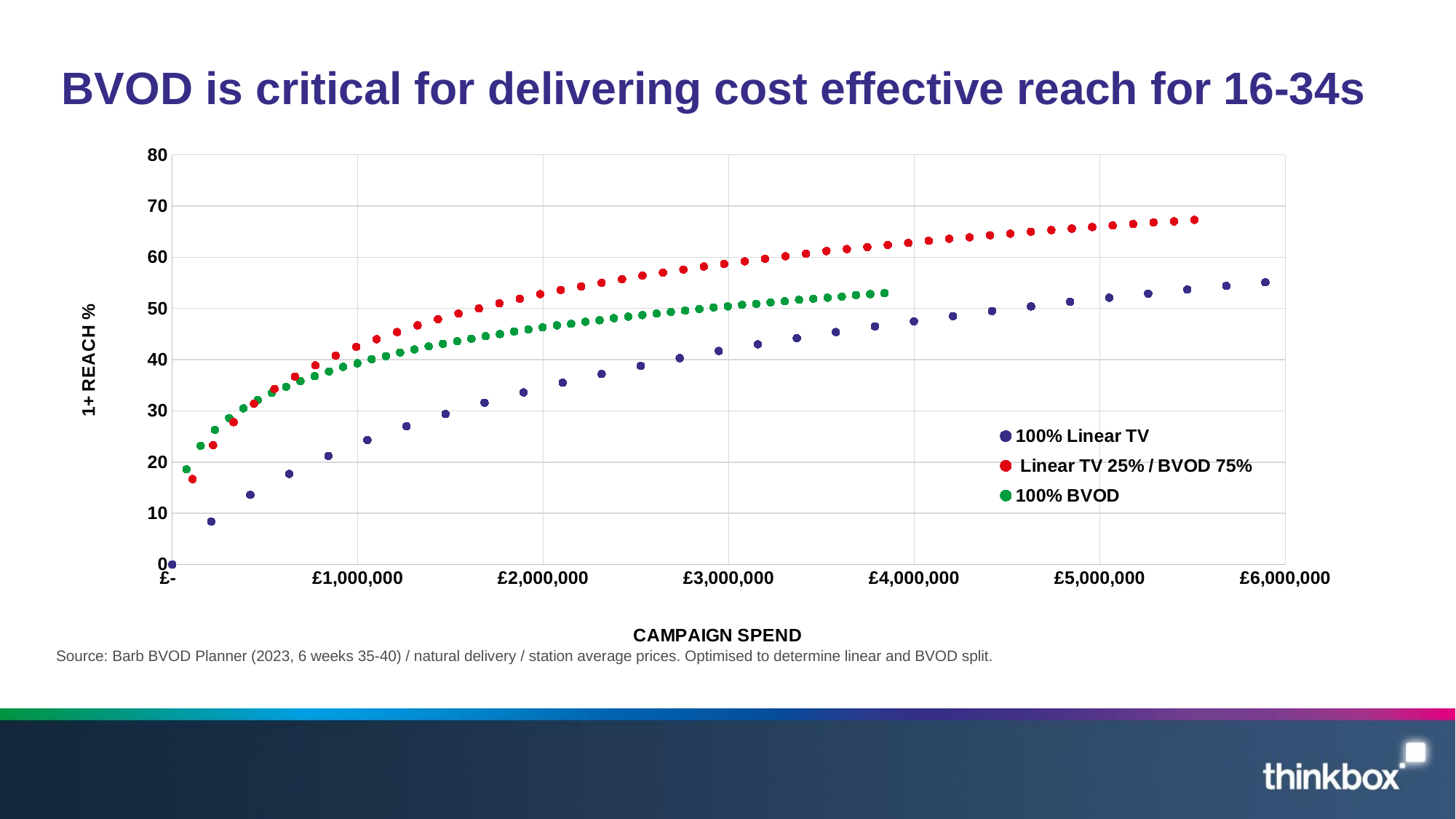
As campaign spend increases along the x axis, does 1+ reach % rise or fall for each series? Rise What are the three series listed in the chart legend? 100% Linear TV, Linear TV 25% / BVOD 75%, 100% BVOD At a campaign spend of £1,000,000, is the 1+ reach % for 100% Linear TV greater or less than 30? less Which series reaches the highest 1+ reach % anywhere on the chart? Linear TV 25% / BVOD 75% What kind of chart is shown on the slide? Scatter chart At a campaign spend of £1,000,000, is the 1+ reach % for 100% BVOD greater or less than 30? greater Is the highest 1+ reach % achieved by the 100% BVOD series greater or less than 60? less At a campaign spend of £2,000,000, which series has the higher 1+ reach %: 100% Linear TV or 100% BVOD? 100% BVOD What is the label on the vertical axis of the chart? 1+ REACH % How many series does the chart legend list? 3